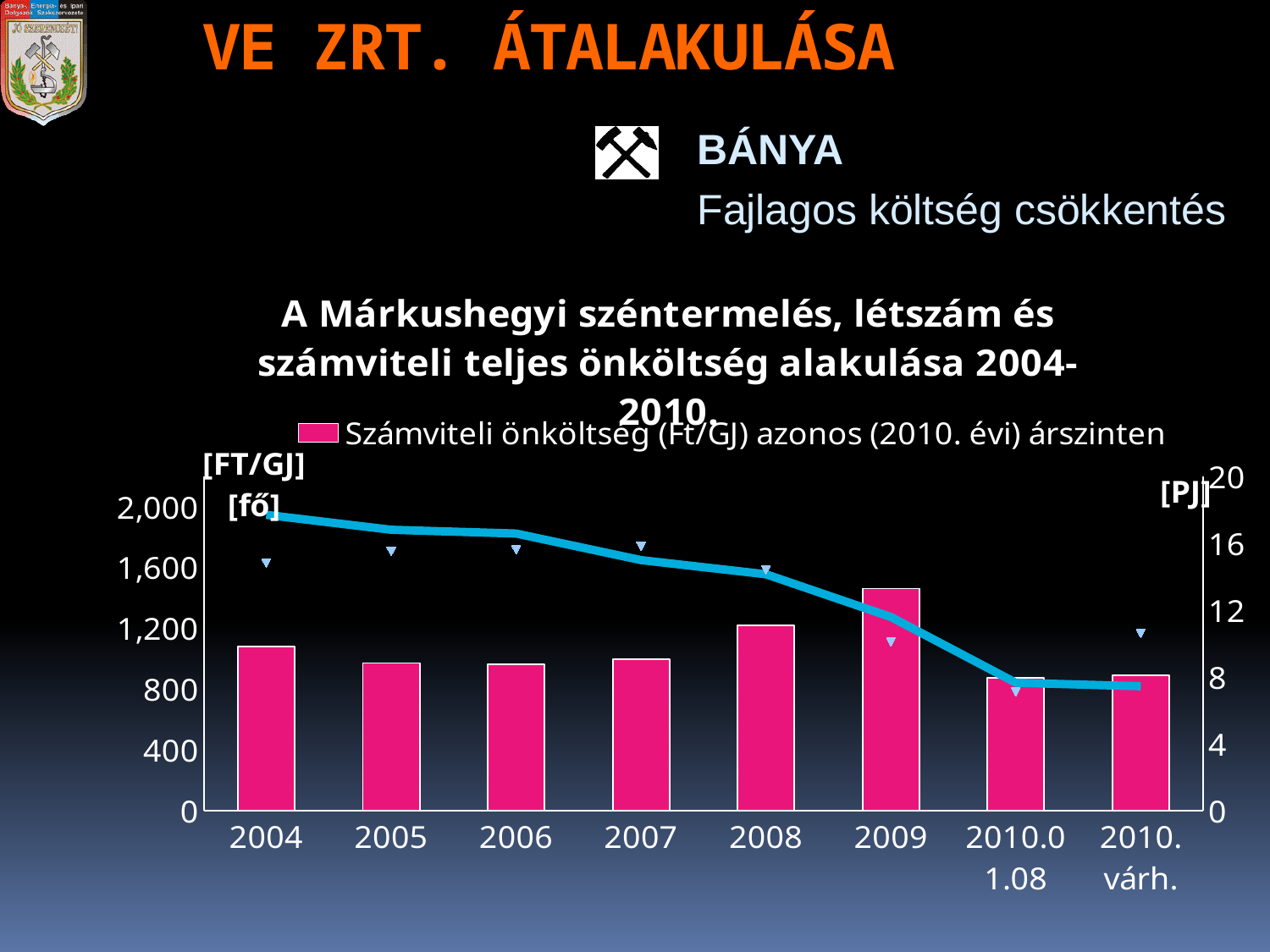
Is the bar for 2005 greater or less than 800? greater Which year has the tallest bar in the chart? 2009 Which bar is taller, 2009 or 2004? 2009 Is the bar for 2004 greater or less than 1,200? less Is the bar for 2009 greater or less than 1,200? greater What kind of chart is shown on the slide? bar and line chart What is the legend entry shown above the chart? Számviteli önköltség (Ft/GJ) azonos (2010. évi) árszinten Does the blue line rise or fall from 2004 to 2010. várh.? fall What unit label is shown on the right-hand axis of the chart? [PJ] Which bar is taller, 2008 or 2007? 2008 How many categories are shown on the x axis of the chart? 8